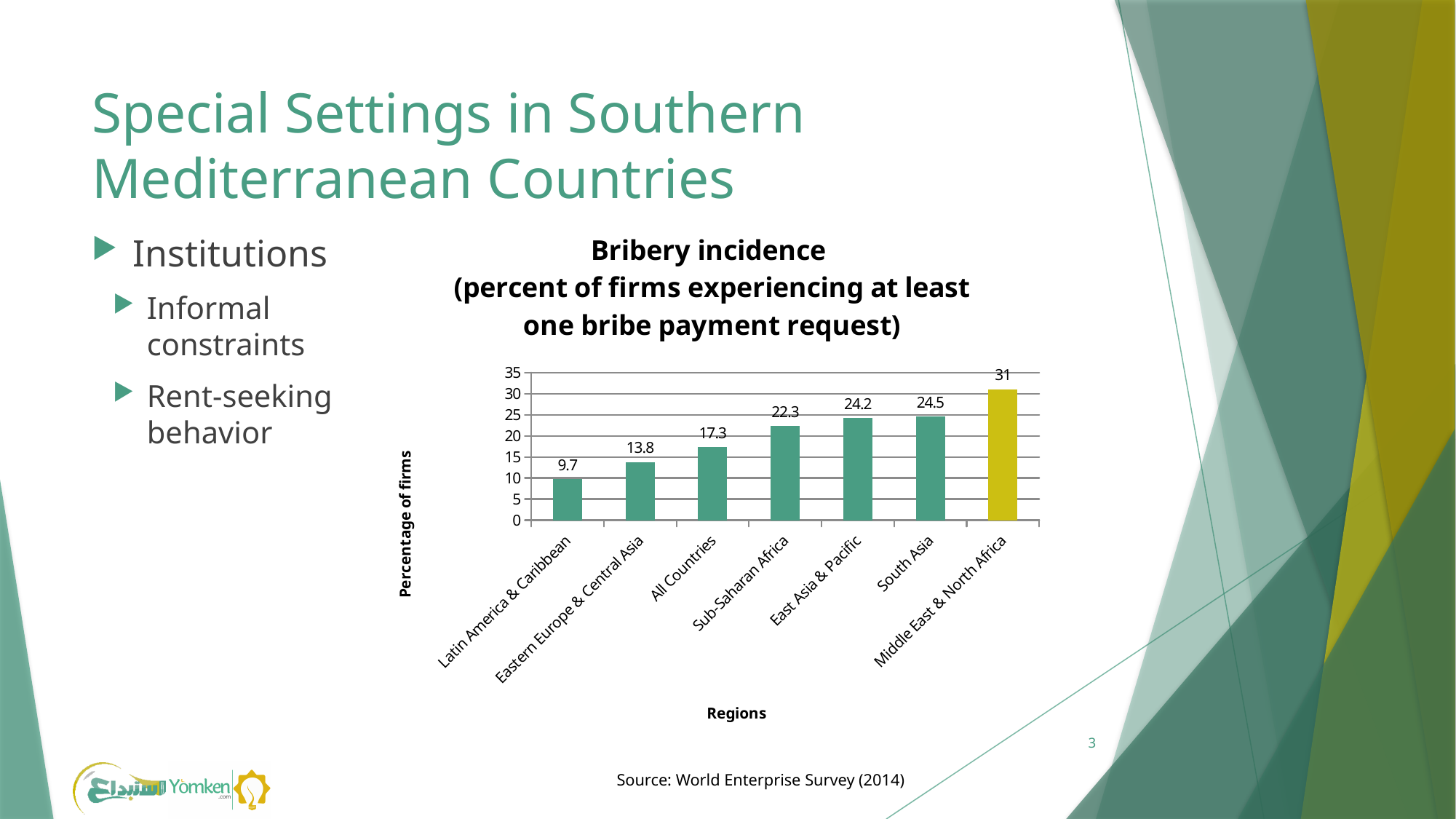
What is the value shown for All Countries? 17.3 Do the values rise or fall from left to right along the x axis? Rise What kind of chart is shown on the slide? Bar chart What is the difference between the values for Eastern Europe & Central Asia and All Countries? 3.5 Which region has the lowest bribery incidence? Latin America & Caribbean Which region has the highest bribery incidence? Middle East & North Africa What is the value shown for Middle East & North Africa? 31 What is the bribery incidence value for Sub-Saharan Africa? 22.3 What is the label of the y axis of the chart? Percentage of firms How many regions are shown on the x axis of the chart? 7 What is the difference between the values for Middle East & North Africa and Latin America & Caribbean? 21.3 Which is larger, the value for East Asia & Pacific or the value for Sub-Saharan Africa? East Asia & Pacific